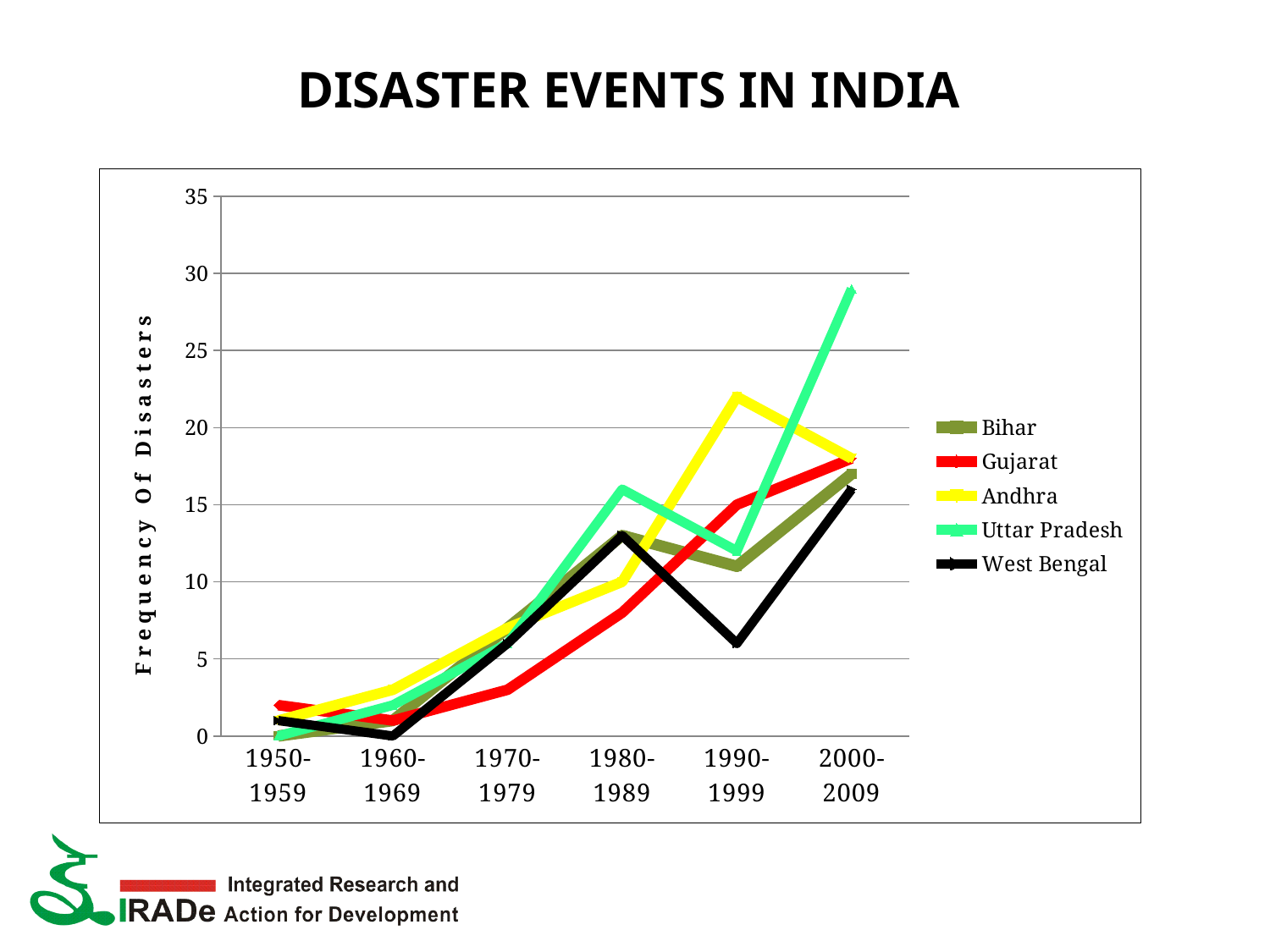
How many time periods are shown on the x axis? 6 How many series does the legend list? 5 In 1980-1989, which is larger: the value for Uttar Pradesh or the value for Gujarat? Uttar Pradesh Which state has the highest frequency of disasters in 2000-2009? Uttar Pradesh Is the value for Andhra in 1990-1999 greater or less than 20? greater Does the frequency of disasters for Gujarat generally rise or fall from 1950-1959 to 2000-2009? rise What kind of chart is shown on the slide? line chart Is the value for West Bengal in 1990-1999 greater or less than 10? less What is the title of the y axis? Frequency Of Disasters Which state has the lowest frequency of disasters in 1990-1999? West Bengal Which state has the highest frequency of disasters in 1990-1999? Andhra Is the value for Uttar Pradesh in 2000-2009 greater or less than 25? greater